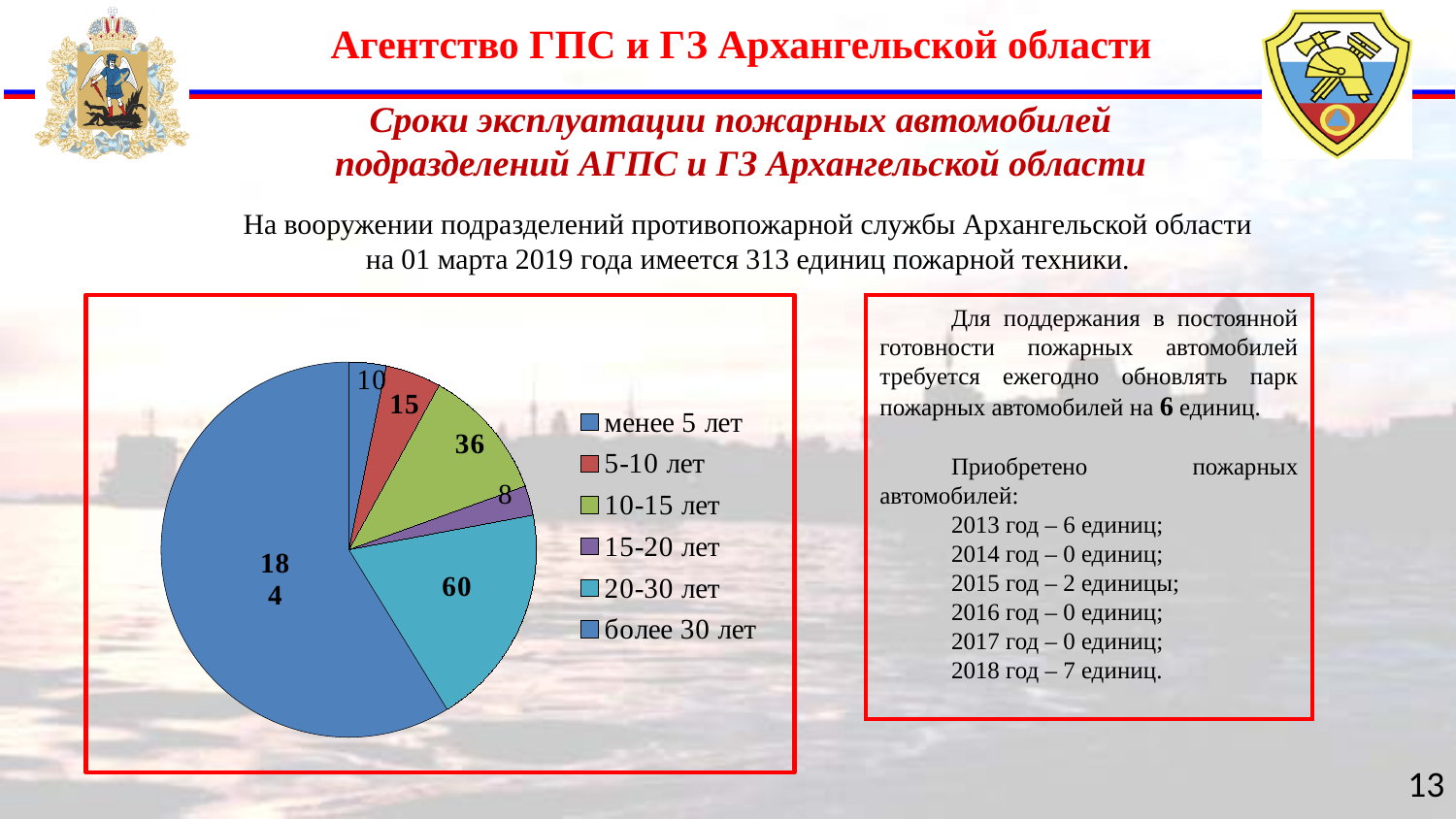
What is the difference between the values for '20-30 лет' and '10-15 лет'? 24 What type of chart is shown on the slide? pie chart What is the total of all slices in the pie chart? 313 How many slices does the pie chart have? 6 Which category has the smallest slice in the pie chart? 15-20 лет What is the value for the 'более 30 лет' slice? 184 How many entries does the legend of the pie chart list? 6 Which category has the largest slice in the pie chart? более 30 лет What is the value for the '20-30 лет' slice? 60 Which is larger, the value for '5-10 лет' or the value for '15-20 лет'? 5-10 лет What is the value for the 'менее 5 лет' slice? 10 What is the value for the '10-15 лет' slice? 36